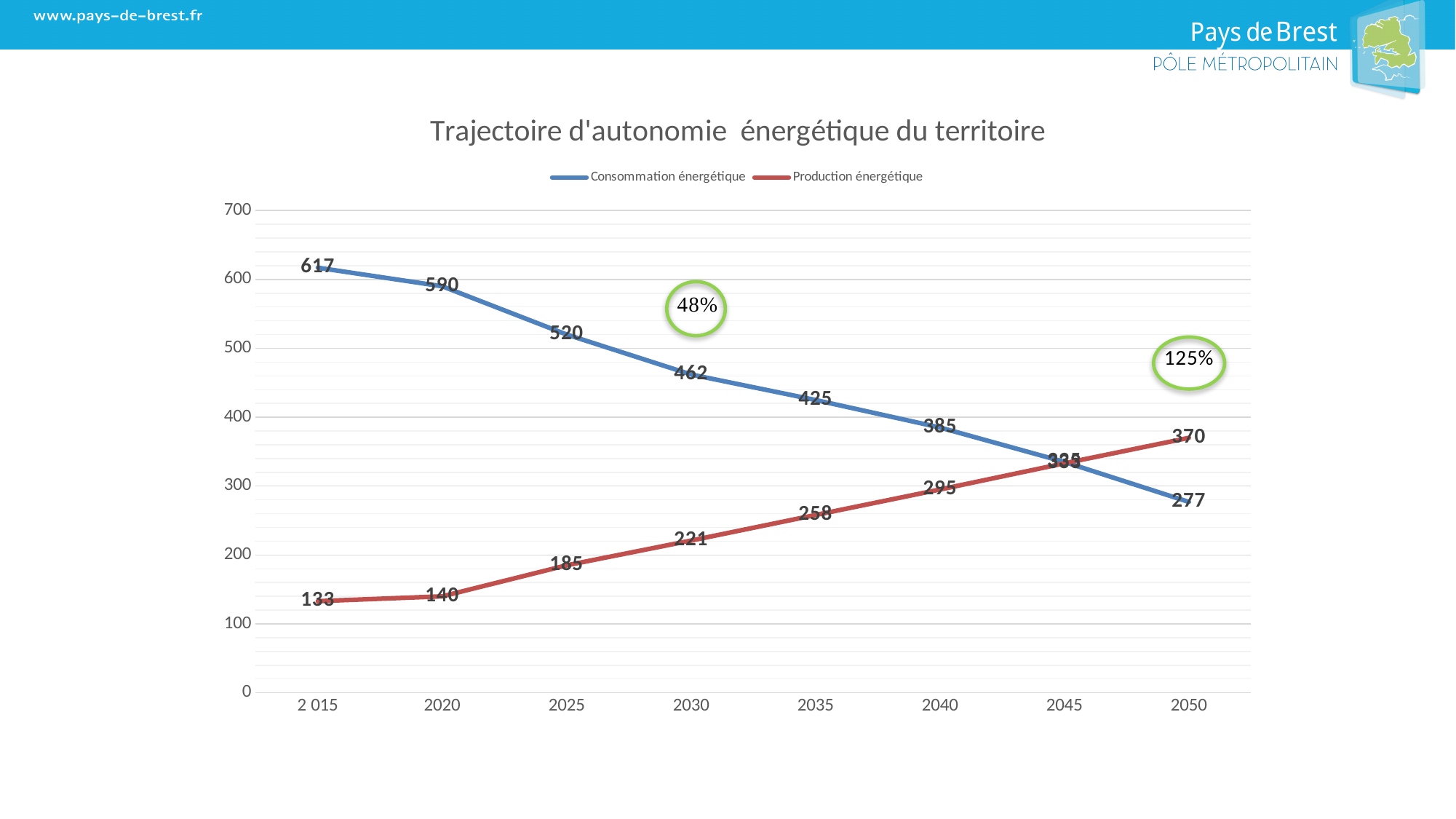
In which year is Consommation énergétique lowest? 2050 What is the value of Production énergétique in 2035? 258 What is the value of Consommation énergétique in 2030? 462 Which is larger in 2050, Consommation énergétique or Production énergétique? Production énergétique What is the value of Consommation énergétique in 2015? 617 What is the difference between Consommation énergétique and Production énergétique in 2015? 484 What type of chart is shown on the slide? line chart What is the value of Production énergétique in 2050? 370 What is the title of the chart? Trajectoire d'autonomie énergétique du territoire In which year is Production énergétique highest? 2050 How many series does the legend list? 2 Does Production énergétique rise or fall from 2015 to 2050? rise